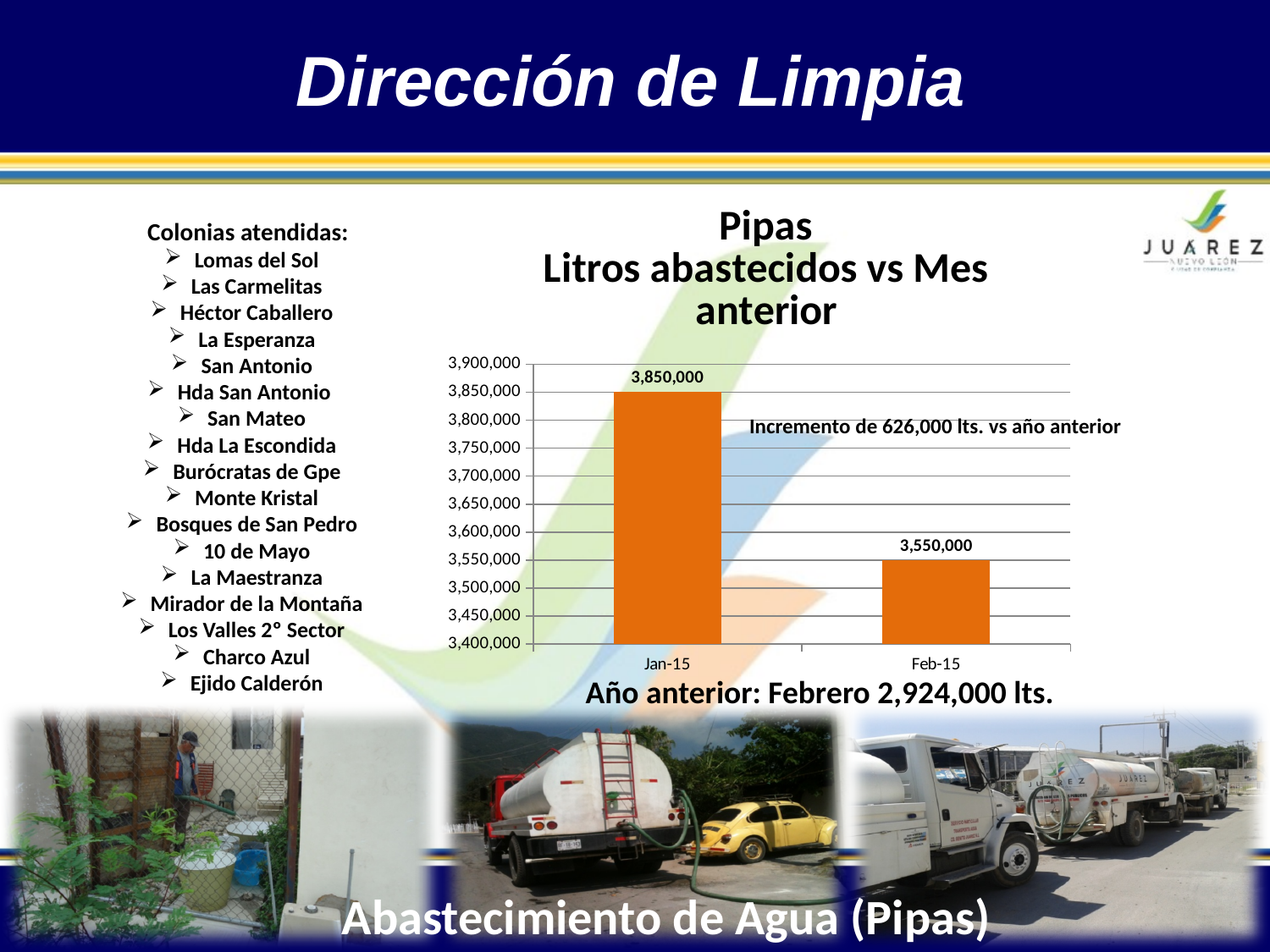
What is the title of the chart? Pipas Litros abastecidos vs Mes anterior Is the value for Feb-15 greater or less than 3,600,000? less What is the value for Feb-15? 3,550,000 What is the value for Jan-15? 3,850,000 Is the value for Jan-15 greater or less than 3,800,000? greater Do the values rise or fall from Jan-15 to Feb-15? fall Which is larger, the value for Jan-15 or Feb-15? Jan-15 Which month has the highest value? Jan-15 Which month has the lowest value? Feb-15 What is the difference between the Jan-15 and Feb-15 values? 300,000 What kind of chart is shown? bar chart How many months are plotted in the chart? 2